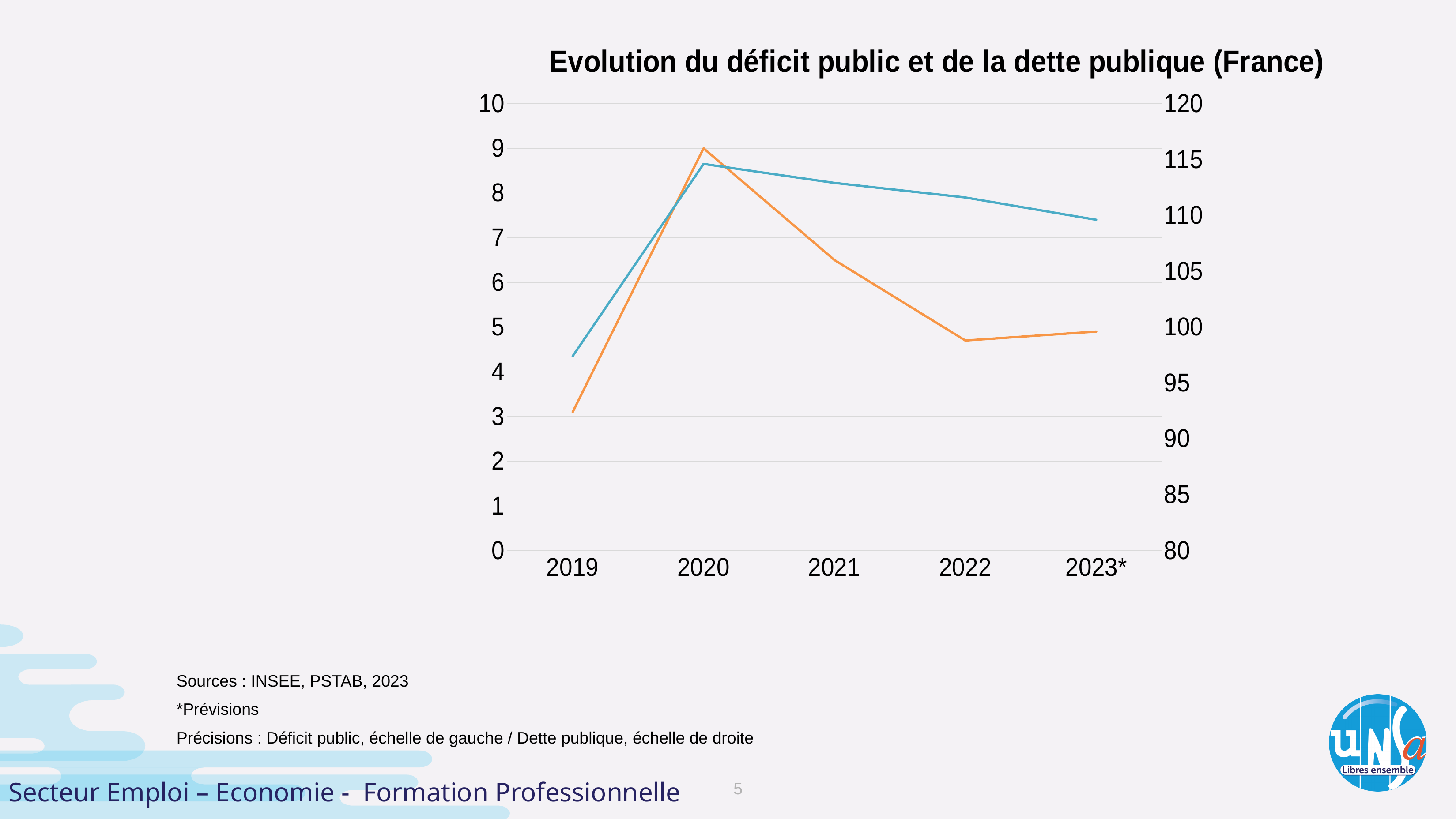
In which year is the déficit public (orange line, left axis) at its lowest? 2019 In which year is the dette publique (blue line, right axis) at its lowest? 2019 Is the dette publique value for 2020 greater or less than 110 on the right axis? greater In which year does the déficit public (orange line, left axis) reach its highest value? 2020 Is the déficit public value for 2019 greater or less than 4 on the left axis? less Which year has the larger déficit public value, 2021 or 2022? 2021 In which year does the dette publique (blue line, right axis) reach its highest value? 2020 What is the title of the chart? Evolution du déficit public et de la dette publique (France) How many years are shown on the x axis of the chart? 5 What kind of chart is shown on the slide? line chart How many series are plotted on the chart? 2 Does the déficit public (orange line) rise or fall between 2020 and 2022? fall